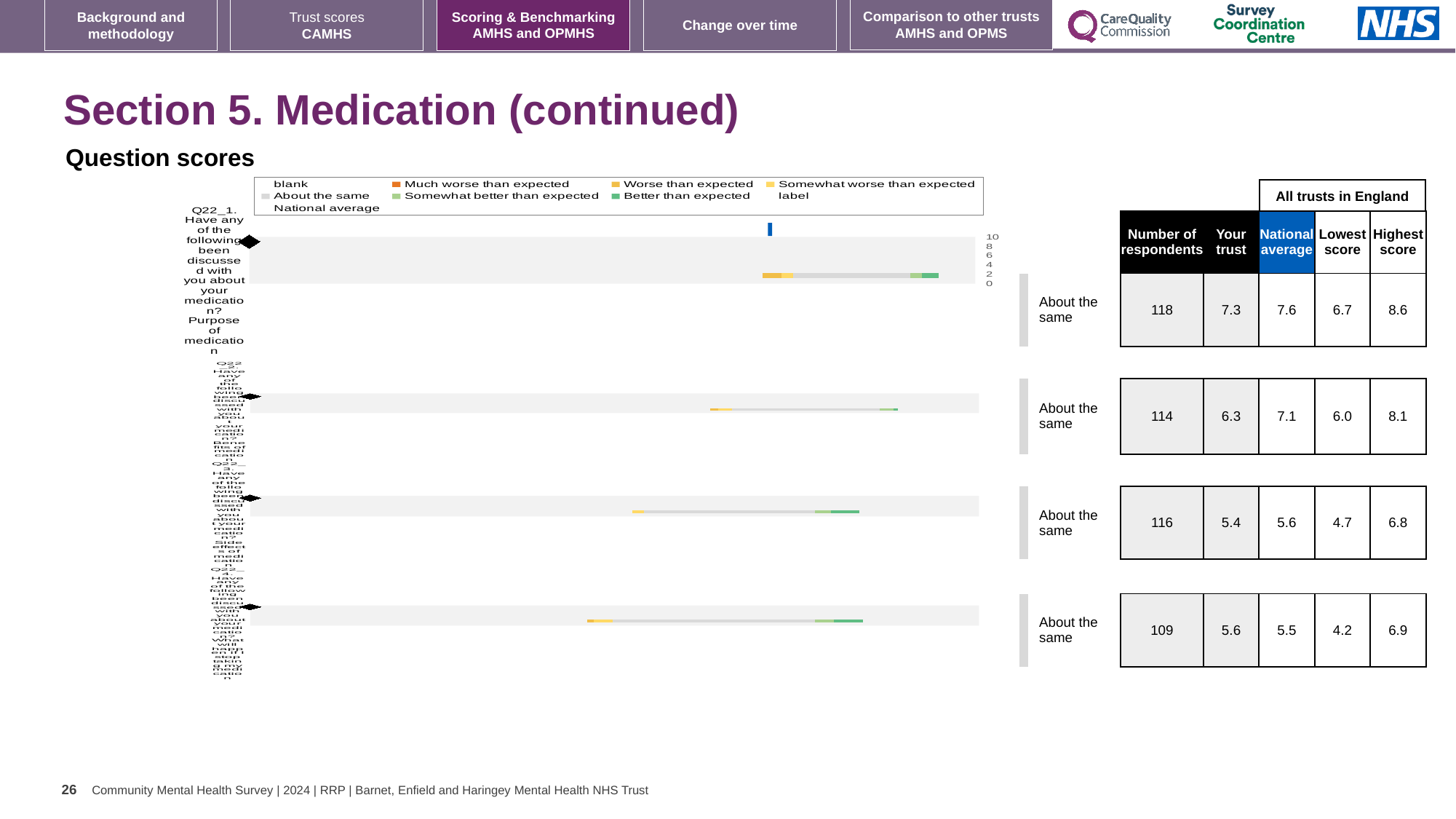
What is the first entry in the chart legend? blank What is the highest tick value shown on the chart's score axis? 10 What benchmark category is shown next to the first question row (Q22_1)? About the same In the table beside the chart, what is the difference between the highest score and the lowest score for the first question row (Q22_1)? 1.9 In the table beside the chart, what is the number of respondents for the first question row (Q22_1)? 118 In the table beside the chart, what is the 'Your trust' score for the third question row? 5.4 In the table beside the chart, which question row has the highest number of respondents? the first row (Q22_1), 118 What kind of chart is shown under 'Question scores'? bar chart How many question rows (bars) does the chart show? 4 In the table beside the chart, what is the highest score for the fourth question row? 6.9 How many entries does the chart legend list? 9 In the table beside the chart, for the fourth question row, which is larger: the 'Your trust' score or the national average? Your trust (5.6)